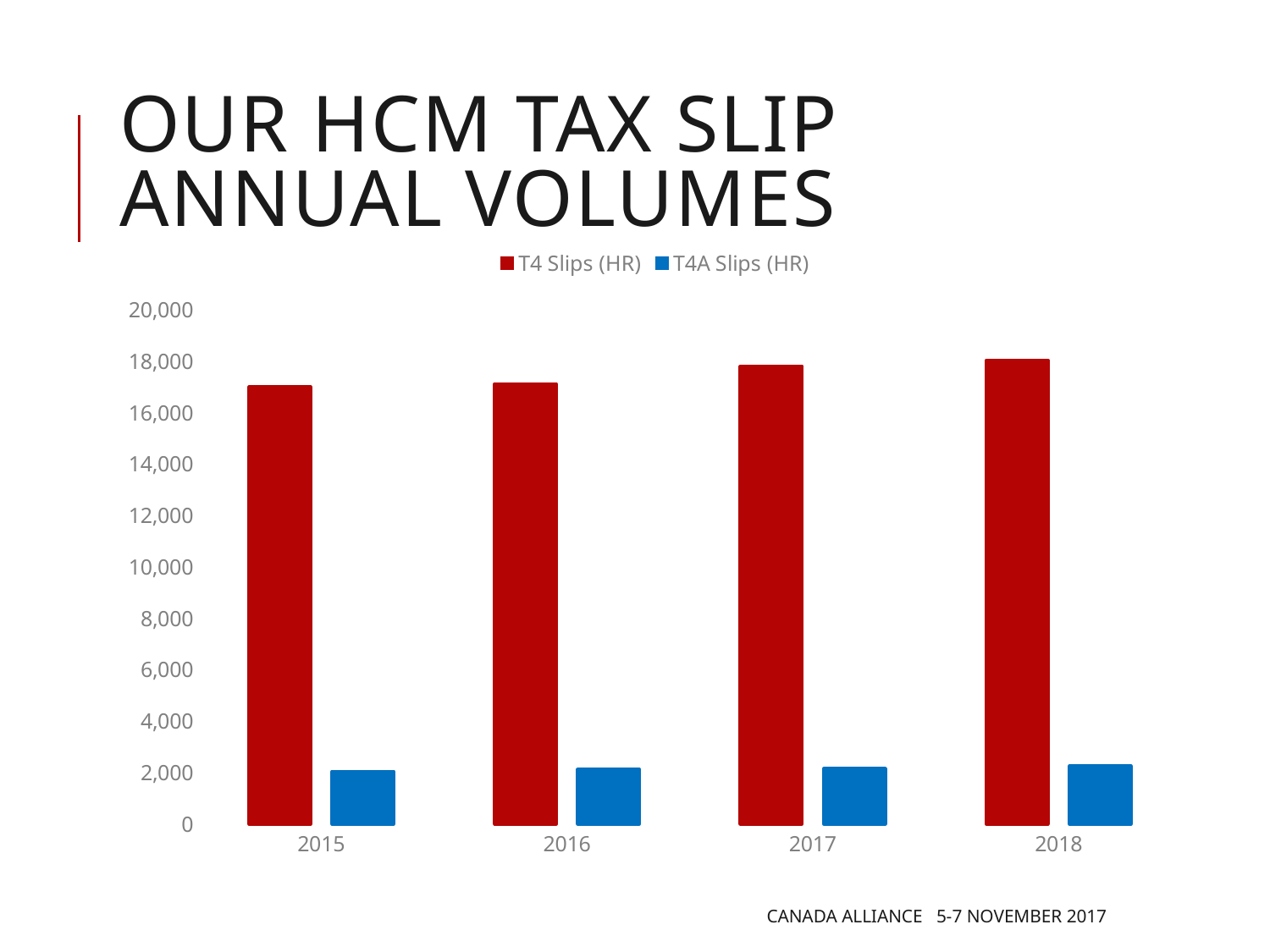
How many series does the legend list? 2 What kind of chart is shown on the slide? bar chart Do the T4 Slips (HR) values rise or fall from 2015 to 2018? rise In which year is the T4 Slips (HR) value highest? 2018 What are the two legend entries? T4 Slips (HR) and T4A Slips (HR) Is the value for T4 Slips (HR) in 2016 greater or less than 18,000? less Is the value for T4 Slips (HR) in 2015 greater or less than 16,000? greater Is the value for T4 Slips (HR) in 2018 greater or less than 14,000? greater Which is larger in 2016, T4 Slips (HR) or T4A Slips (HR)? T4 Slips (HR) How many years are shown on the x axis? 4 Which series is shown in red? T4 Slips (HR)